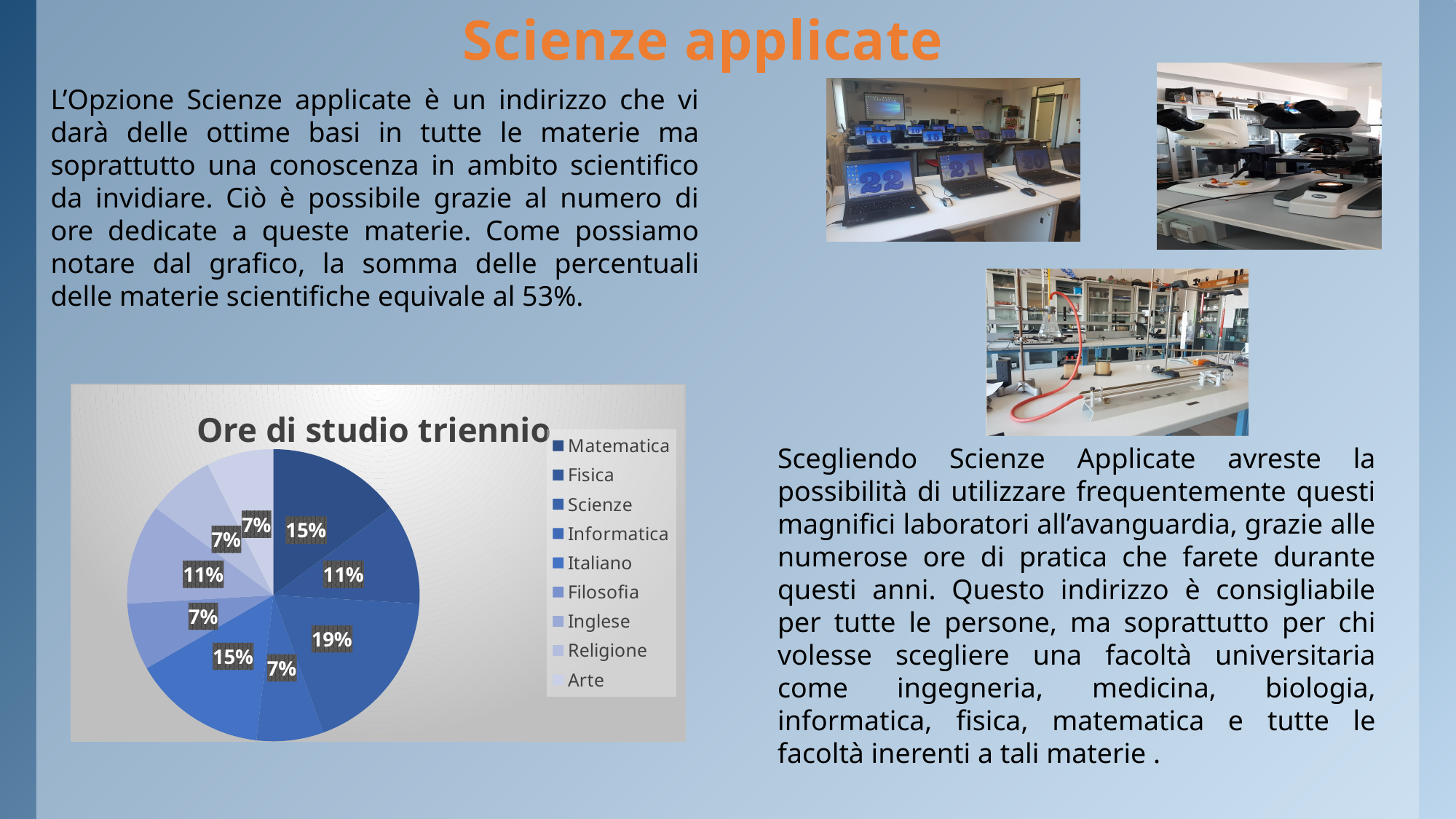
How many slices are labelled 7%? 4 What percentage is shown for Fisica? 11% What percentage is shown for Matematica? 15% What percentage is shown for Italiano? 15% Which legend entry is listed first in the chart legend? Matematica What kind of chart is shown on the slide? pie chart What is the title of the chart? Ore di studio triennio Which is larger, the slice for Matematica or the slice for Fisica? Matematica How many categories (slices) does the pie chart have? 9 Which subject has the largest slice in the pie chart? Scienze What is the difference in percentage points between Scienze and Fisica? 8 What percentage is shown for Scienze? 19%